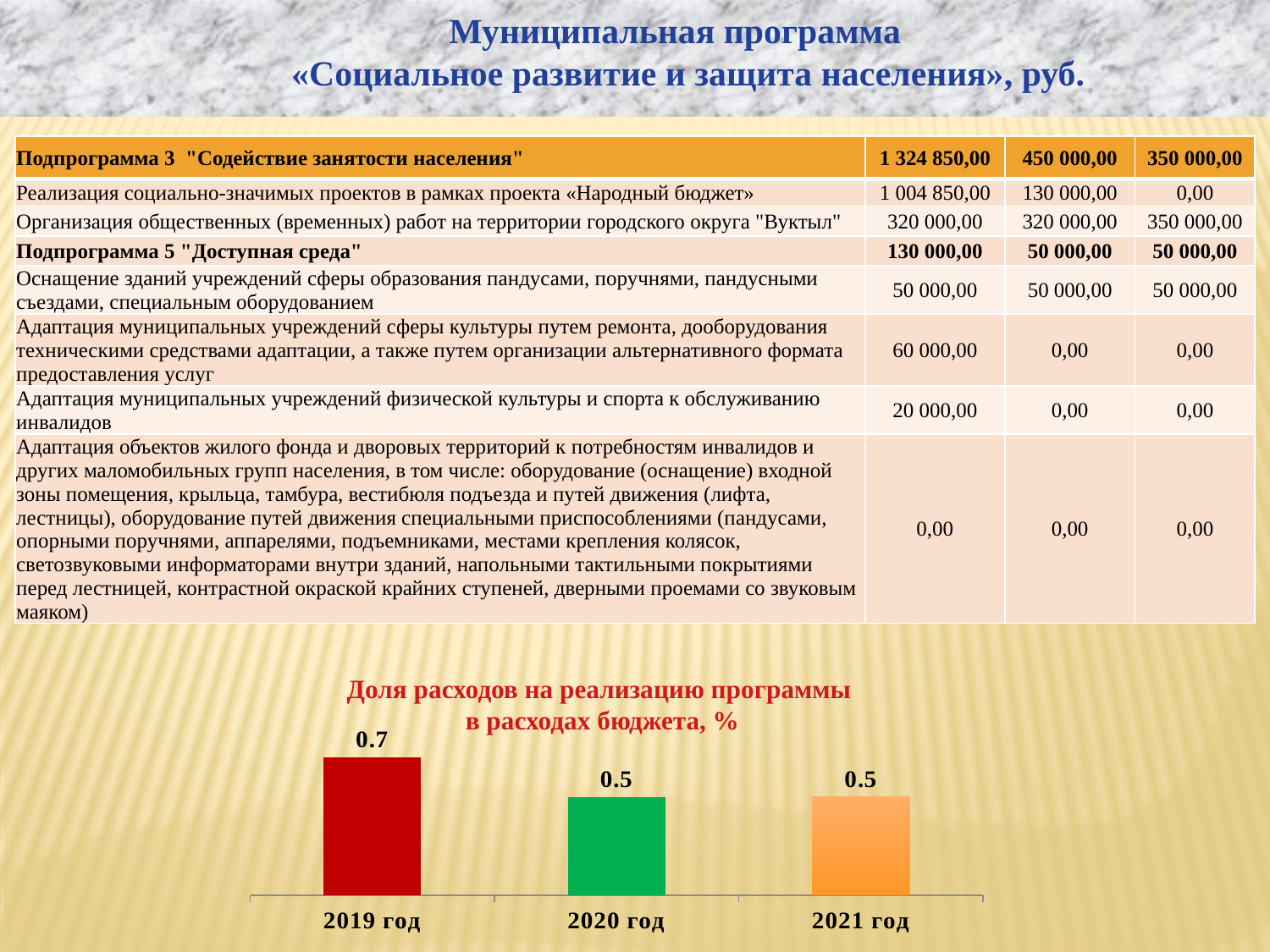
What is the value for 2019 год in the chart? 0.7 What is the value for 2021 год in the chart? 0.5 Do the values rise or fall from 2019 год to 2020 год? fall What colour is the bar for 2019 год? red Which year has the highest value in the chart? 2019 год How many categories (years) are shown in the chart? 3 What is the difference between the values for 2019 год and 2020 год? 0.2 What is the title of the chart? Доля расходов на реализацию программы в расходах бюджета, % Which is larger, the value for 2019 год or the value for 2021 год? 2019 год What kind of chart is shown on the slide? bar chart What is the value for 2020 год in the chart? 0.5